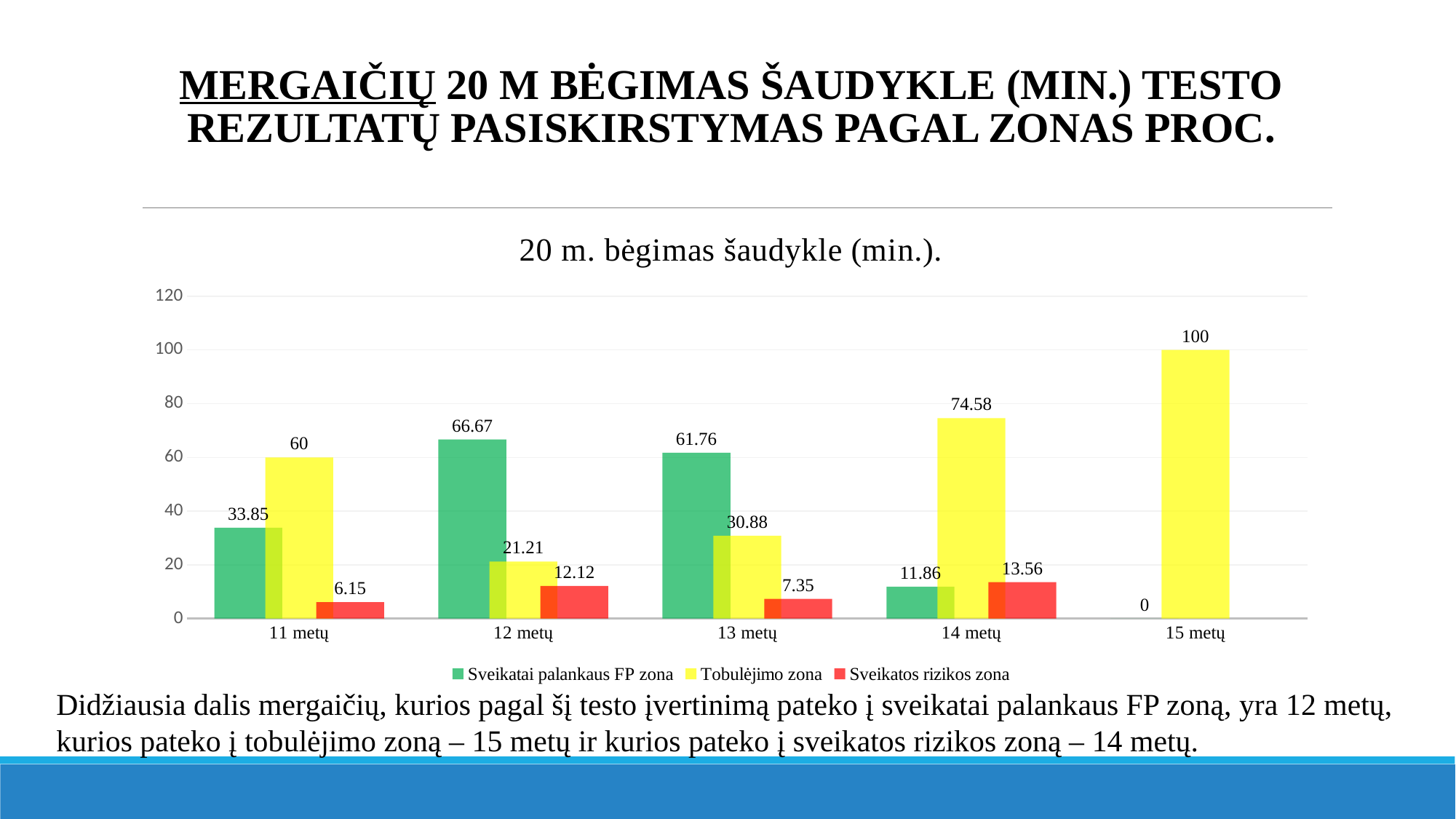
How many series does the legend list? 3 How many age groups are shown on the x axis? 5 Which age group has the highest value for Sveikatos rizikos zona? 14 metų What is the total of the three zones at 11 metų? 100 What is the value for Sveikatos rizikos zona at 13 metų? 7.35 At 11 metų, which is larger: Sveikatai palankaus FP zona or Tobulėjimo zona? Tobulėjimo zona Which age group has the highest value for Tobulėjimo zona? 15 metų Which age group has the lowest value for Sveikatai palankaus FP zona? 15 metų What is the value for Sveikatai palankaus FP zona at 12 metų? 66.67 What is the value for Tobulėjimo zona at 14 metų? 74.58 What type of chart is shown on the slide? Bar chart What is the difference between Sveikatai palankaus FP zona and Tobulėjimo zona at 12 metų? 45.46